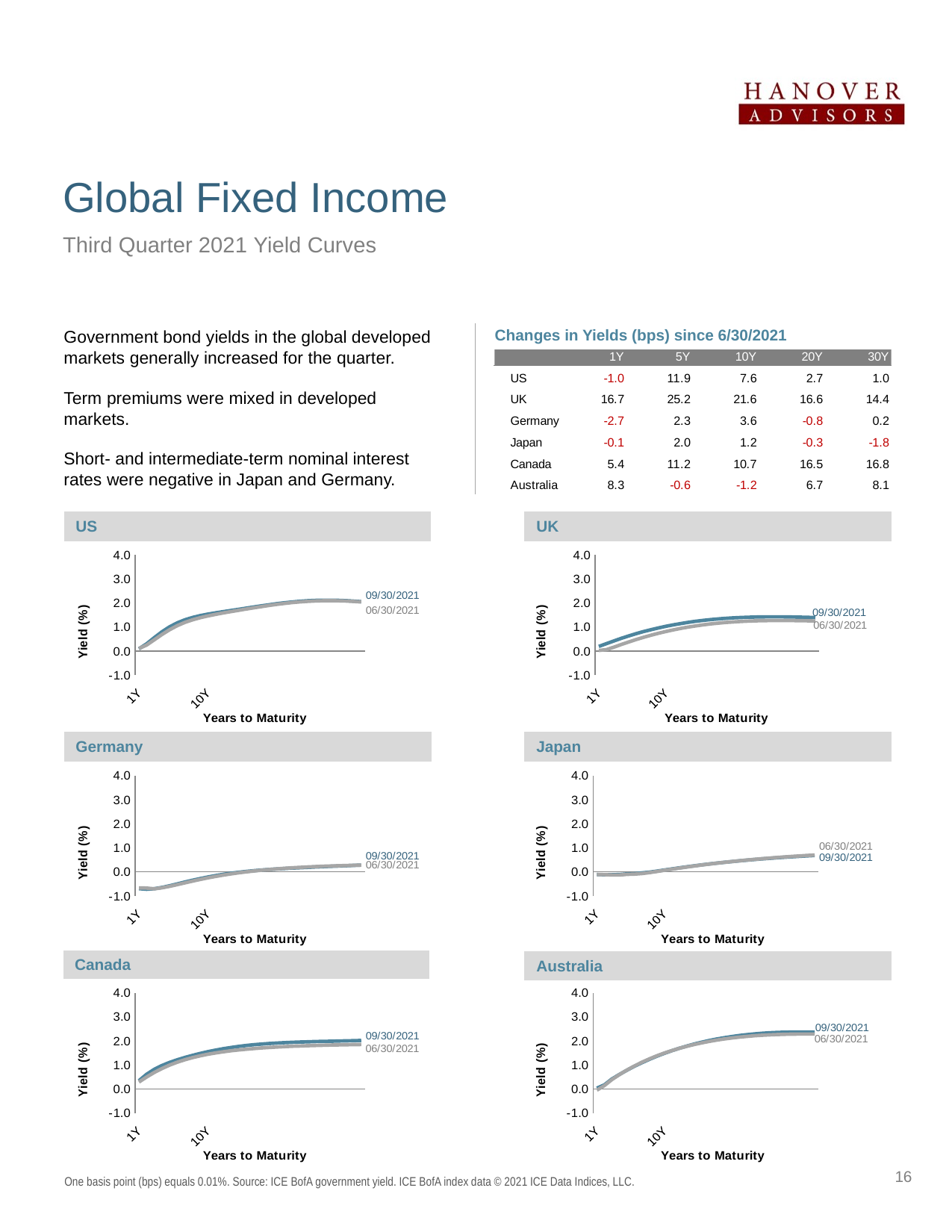
How many yield curve charts are shown on the slide? 6 How many series does the UK chart show? 2 In the UK chart, is the 09/30/2021 value at the longest maturity greater or less than 2.0? less What kind of chart is the US chart? line chart In the US chart, is the 09/30/2021 value at 1Y greater or less than 1.0? less In the Australia chart, is the 09/30/2021 value at the longest maturity greater or less than 2.0? greater In the UK chart, which line is higher at 1Y, 09/30/2021 or 06/30/2021? 09/30/2021 In the Australia chart, do yields rise or fall as years to maturity increase? rise What is the x-axis title of the Canada chart? Years to Maturity